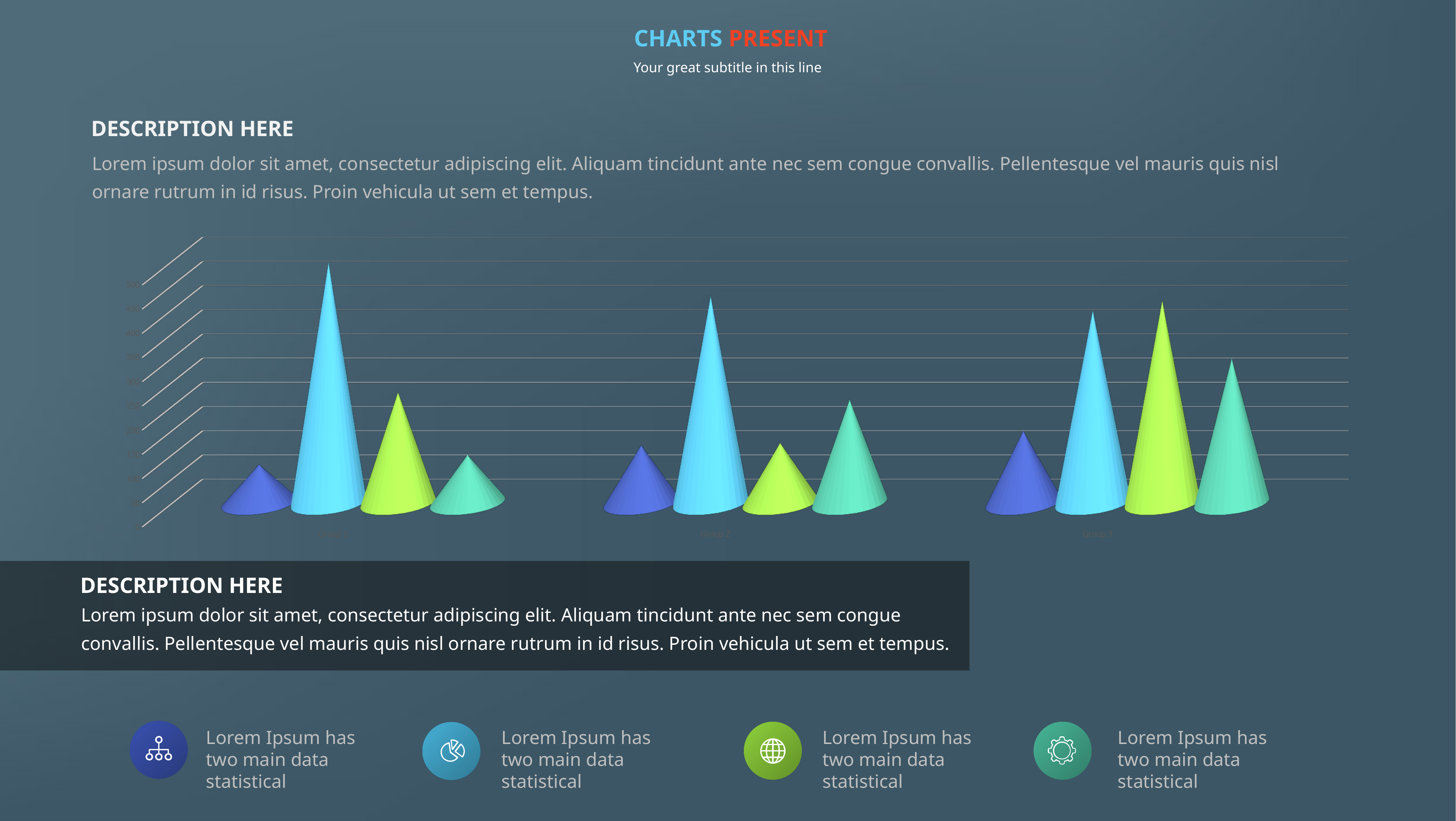
Is the value of the yellow-green cone in Group 3 greater or less than 300? greater Which group contains the tallest cone in the chart? Group 1 What is the title shown at the top of the slide above the chart? CHARTS PRESENT What kind of chart is shown on the slide? bar chart Do the values of the dark blue cones rise or fall from Group 1 to Group 3? rise Which is larger: the yellow-green cone in Group 1 or the yellow-green cone in Group 3? Group 3 How many cones (bars) are plotted for each group in the chart? 4 Is the value of the tallest light blue cone in Group 1 greater or less than 400? greater Which is larger: the teal cone in Group 1 or the teal cone in Group 3? Group 3 Which group has the shortest dark blue cone? Group 1 How many groups are shown along the x axis of the chart? 3 Is the value of the dark blue cone in Group 1 greater or less than 200? less